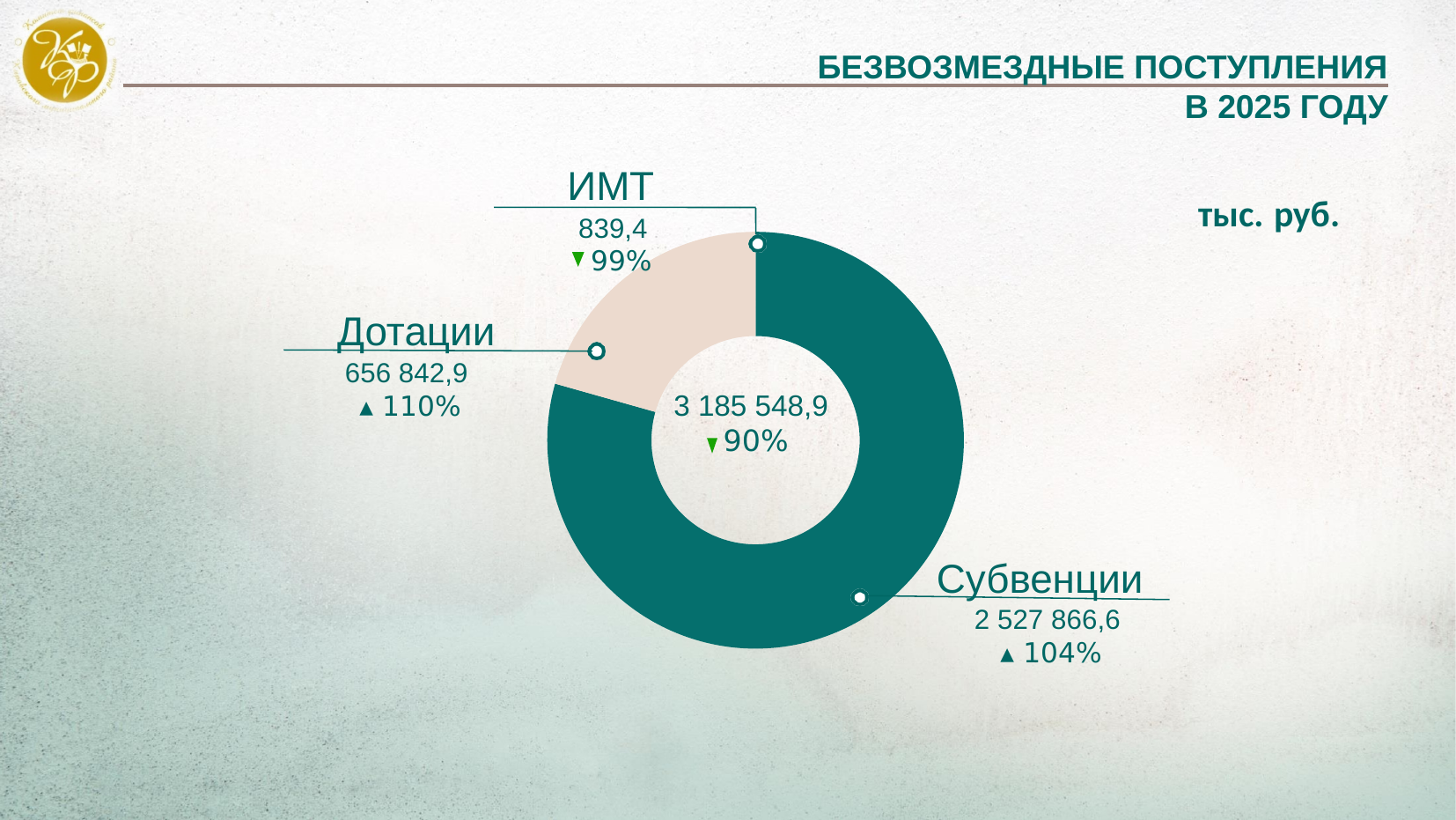
What is the value for ИМТ on the donut chart? 839,4 What is the total value shown in the centre of the donut chart? 3 185 548,9 What is the value for Дотации on the donut chart? 656 842,9 What is the value for Субвенции on the donut chart? 2 527 866,6 Which category has the smallest value on the donut chart? ИМТ What percentage change is shown for Субвенции? ▲ 104% Which is larger: the value for Дотации or the value for ИМТ? Дотации What percentage change is shown for Дотации? ▲ 110% How many categories are shown on the donut chart? 3 Which category has the largest value on the donut chart? Субвенции What type of chart is shown on the slide? Donut (pie) chart What is the difference between the values for Субвенции and Дотации? 1 871 023,7